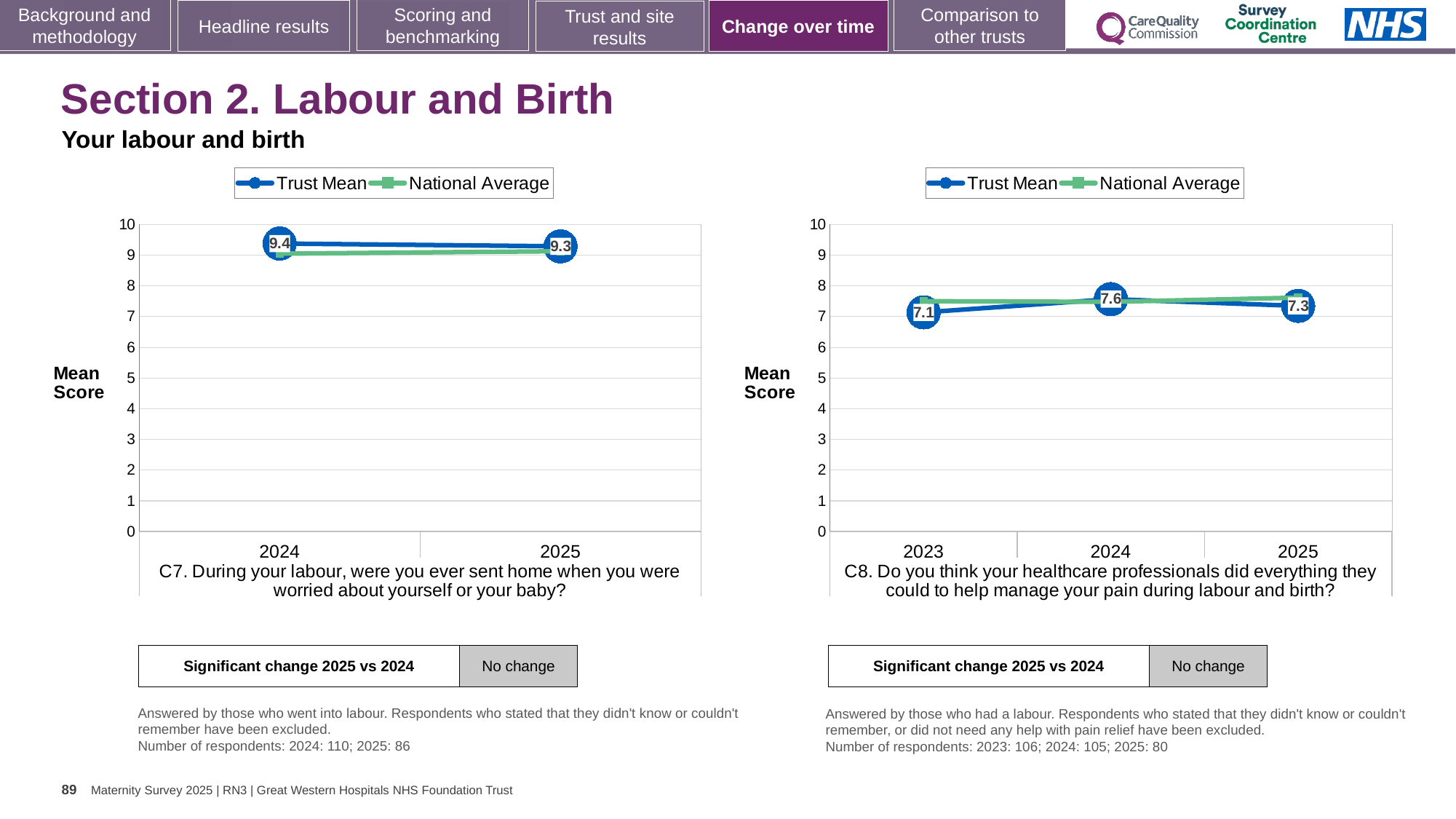
In the C8 chart (right), is the National Average for 2023 greater or less than 7? greater How many years are shown on the x axis of the C8 chart (right)? 3 In the C8 chart (right), what is the Trust Mean for 2023? 7.1 In the C8 chart (right), what is the Trust Mean for 2024? 7.6 In the C7 chart (left), what is the Trust Mean for 2025? 9.3 In the C8 chart (right), which year has the highest Trust Mean? 2024 How many series does the legend of the C7 chart (left) list? 2 What kind of chart is the C8 chart (right)? Line chart In the C8 chart (right), which year has the lowest Trust Mean? 2023 In the C7 chart (left), what is the Trust Mean for 2024? 9.4 In the C7 chart (left), what is the difference between the Trust Mean for 2024 and 2025? 0.1 In the C8 chart (right), what is the difference between the Trust Mean for 2024 and 2023? 0.5